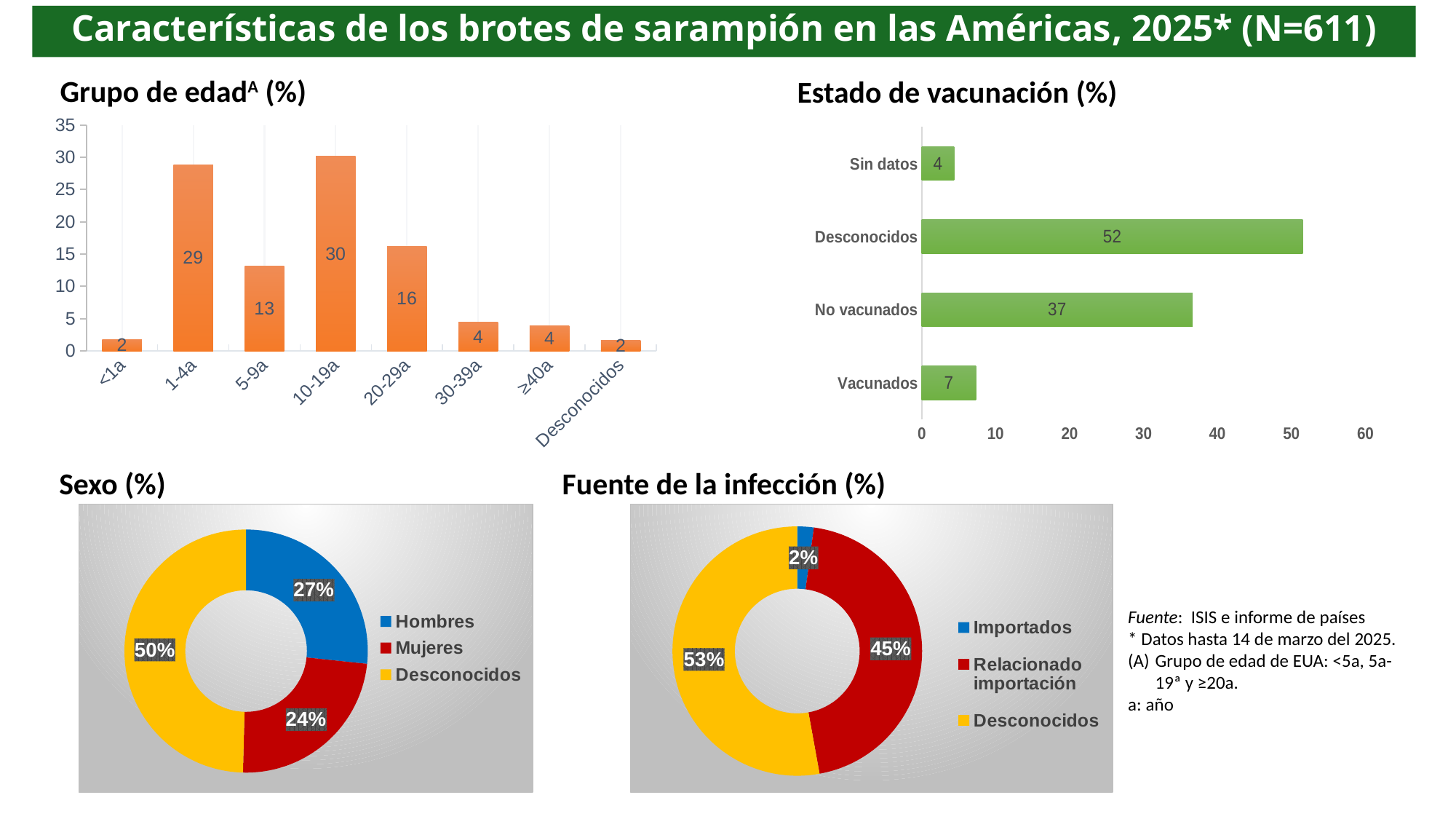
In the 'Estado de vacunación (%)' chart, which category has the lowest value? Sin datos In the 'Grupo de edad (%)' chart, what is the value for the 10-19a age group? 30 In the 'Sexo (%)' chart, how many entries does the legend list? 3 In the 'Estado de vacunación (%)' chart, is the value for 'Desconocidos' greater or less than 50? greater In the 'Grupo de edad (%)' chart, what is the difference between the values for 1-4a and 5-9a? 16 In the 'Estado de vacunación (%)' chart, what is the value for 'No vacunados'? 37 In the 'Grupo de edad (%)' chart, how many categories are shown on the x axis? 8 In the 'Fuente de la infección (%)' chart, what share is labelled for 'Relacionado importación'? 45% In the 'Grupo de edad (%)' chart, which age group has the highest value? 10-19a In the 'Sexo (%)' chart, what share is labelled for 'Mujeres'? 24% What kind of chart is the 'Estado de vacunación (%)' chart? Bar chart In the 'Estado de vacunación (%)' chart, which is larger, 'Desconocidos' or 'No vacunados'? Desconocidos